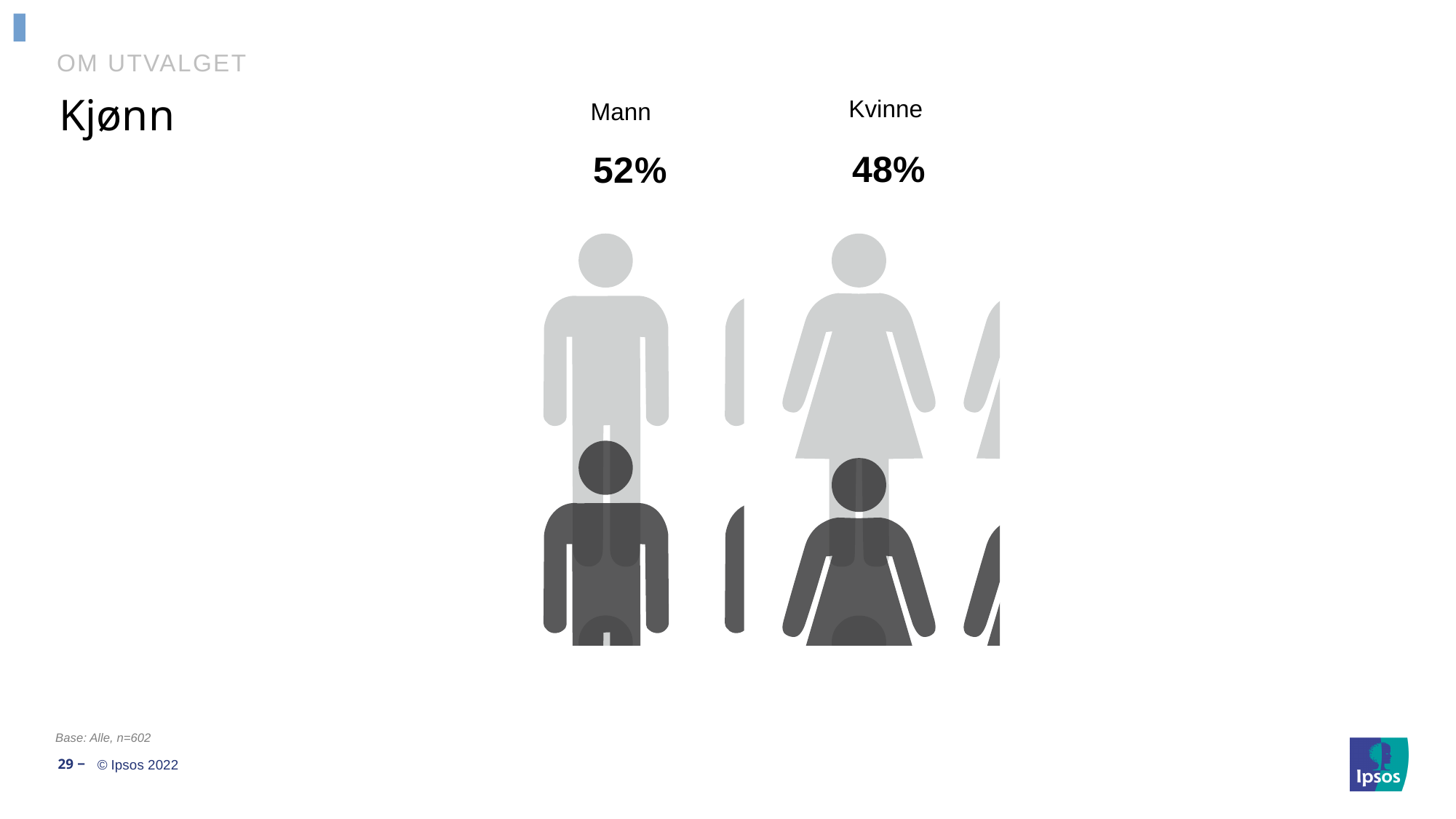
Is the value for Mann larger or smaller than the value for Kvinne? larger What kind of chart is used to show the gender split? Pictogram (icon chart) What is the difference in percentage points between Mann and Kvinne? 4 percentage points What do the values for Mann and Kvinne add up to? 100% How many categories are shown in the chart? 2 What is the base (sample size) stated for the chart? Alle, n=602 Which category has the lower share? Kvinne What is the title of the chart? Kjønn What is the value shown for Kvinne? 48% What is the value shown for Mann? 52% Which category has the higher share, Mann or Kvinne? Mann